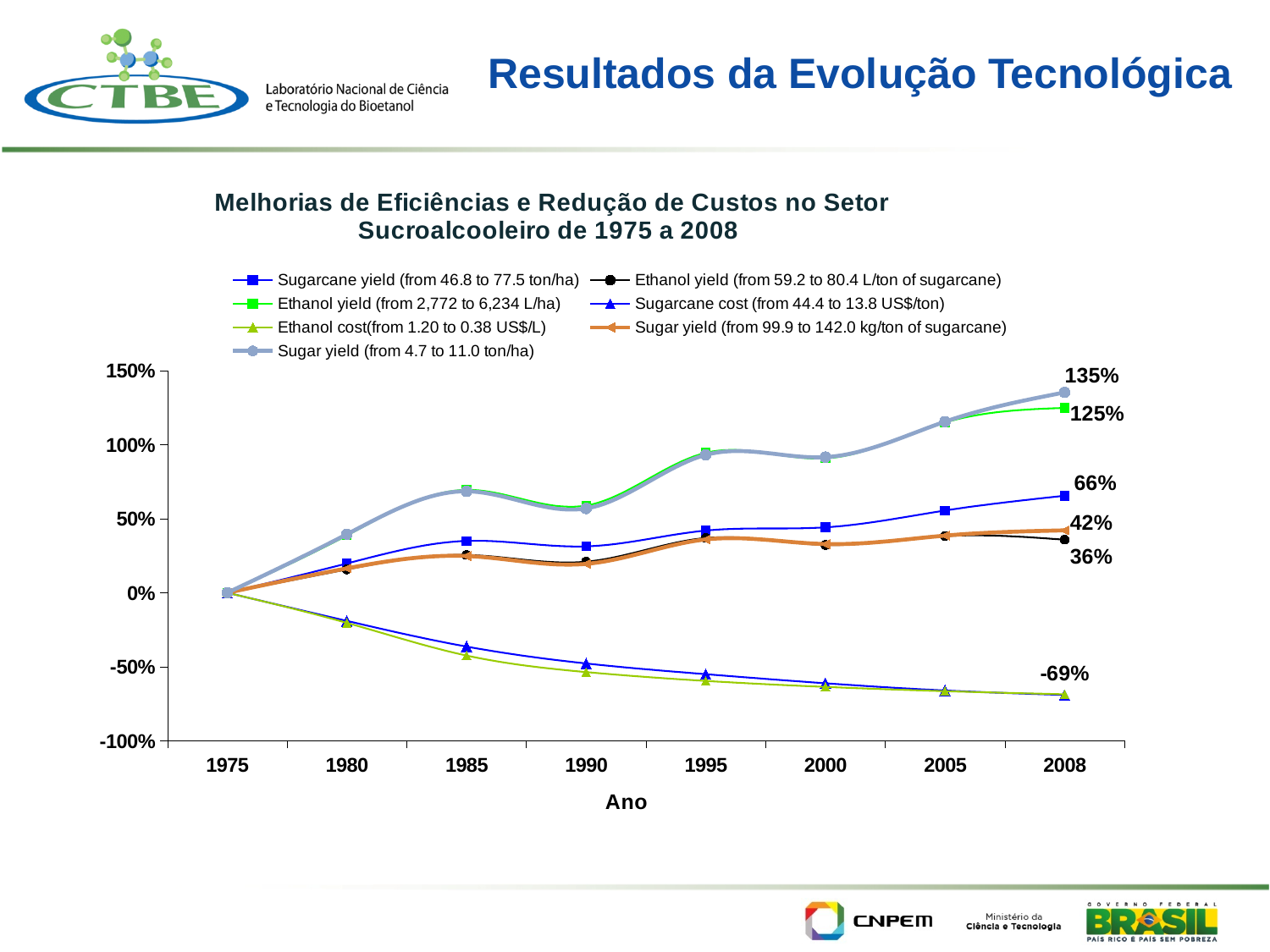
How many series does the legend list? 7 What is the value for Ethanol cost (from 1.20 to 0.38 US$/L) in 2008? -69% What is the value for Sugar yield (from 4.7 to 11.0 ton/ha) in 2008? 135% How many years are marked along the x axis? 8 Is the value for Sugar yield (from 4.7 to 11.0 ton/ha) in 1995 greater or less than 50%? greater What is the value for Ethanol yield (from 2,772 to 6,234 L/ha) in 2008? 125% What is the difference between the 2008 values of Sugar yield (from 4.7 to 11.0 ton/ha) and Ethanol yield (from 2,772 to 6,234 L/ha)? 10 percentage points Does the Sugarcane cost (from 44.4 to 13.8 US$/ton) series rise or fall from 1975 to 2008? fall In 2008, which is larger: Sugarcane yield (from 46.8 to 77.5 ton/ha) or Sugar yield (from 99.9 to 142.0 kg/ton of sugarcane)? Sugarcane yield (from 46.8 to 77.5 ton/ha) What is the value for Sugarcane yield (from 46.8 to 77.5 ton/ha) in 2008? 66% Which series has the highest value in 2008? Sugar yield (from 4.7 to 11.0 ton/ha) What kind of chart is shown on the slide? line chart